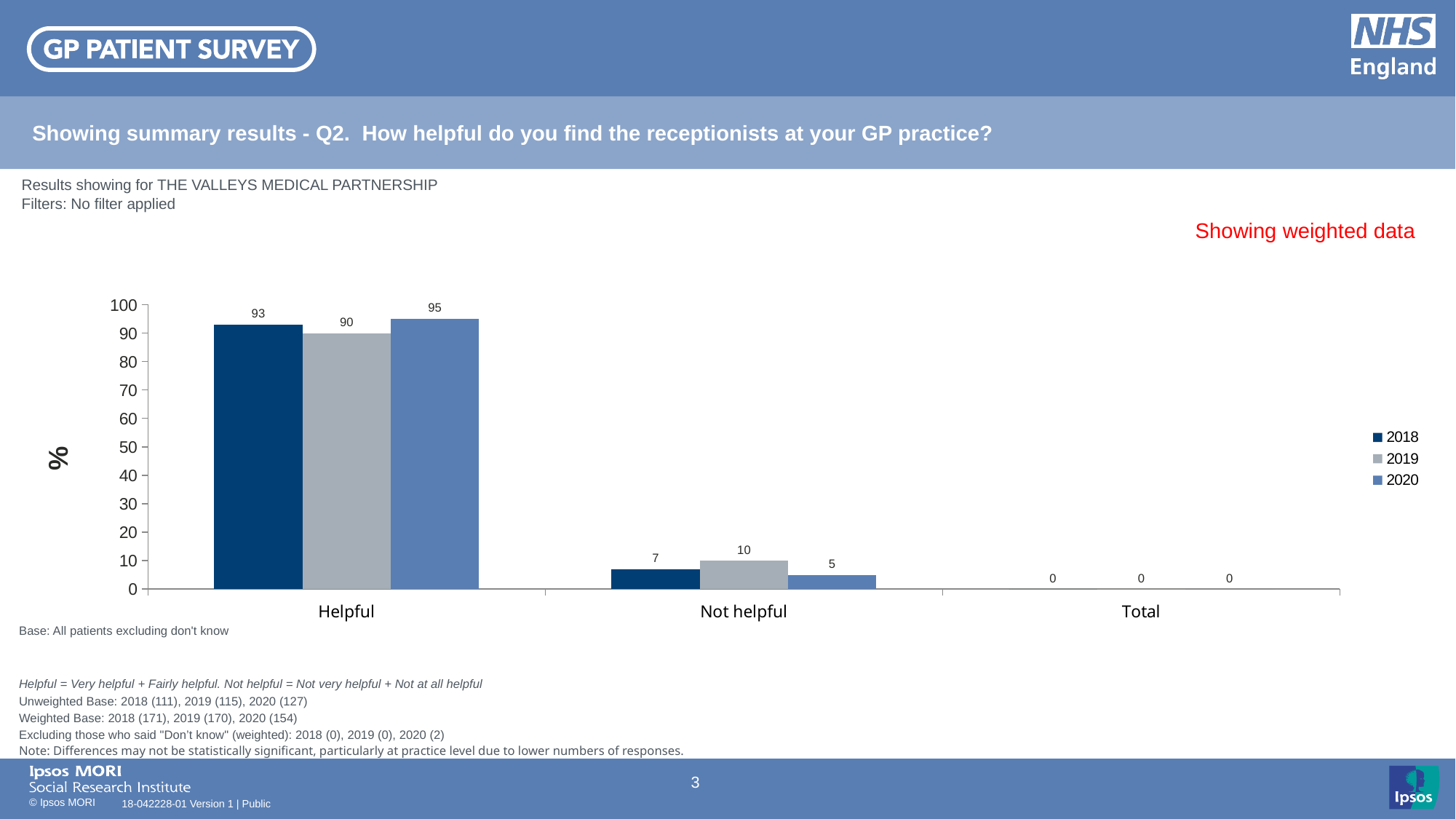
Which is larger: the Not helpful value for 2018 or for 2019? 2019 What label is shown on the y axis? % What is the difference between the Helpful values for 2020 and 2019? 5 How many categories are shown on the x axis? 3 Which year has the highest value for Helpful? 2020 What is the value for Helpful in 2018? 93 What kind of chart is shown on the slide? Bar chart Which year has the lowest value for Not helpful? 2020 What is the value for Not helpful in 2019? 10 What is the value for Helpful in 2020? 95 What is the value for Total in 2020? 0 How many series does the legend list? 3